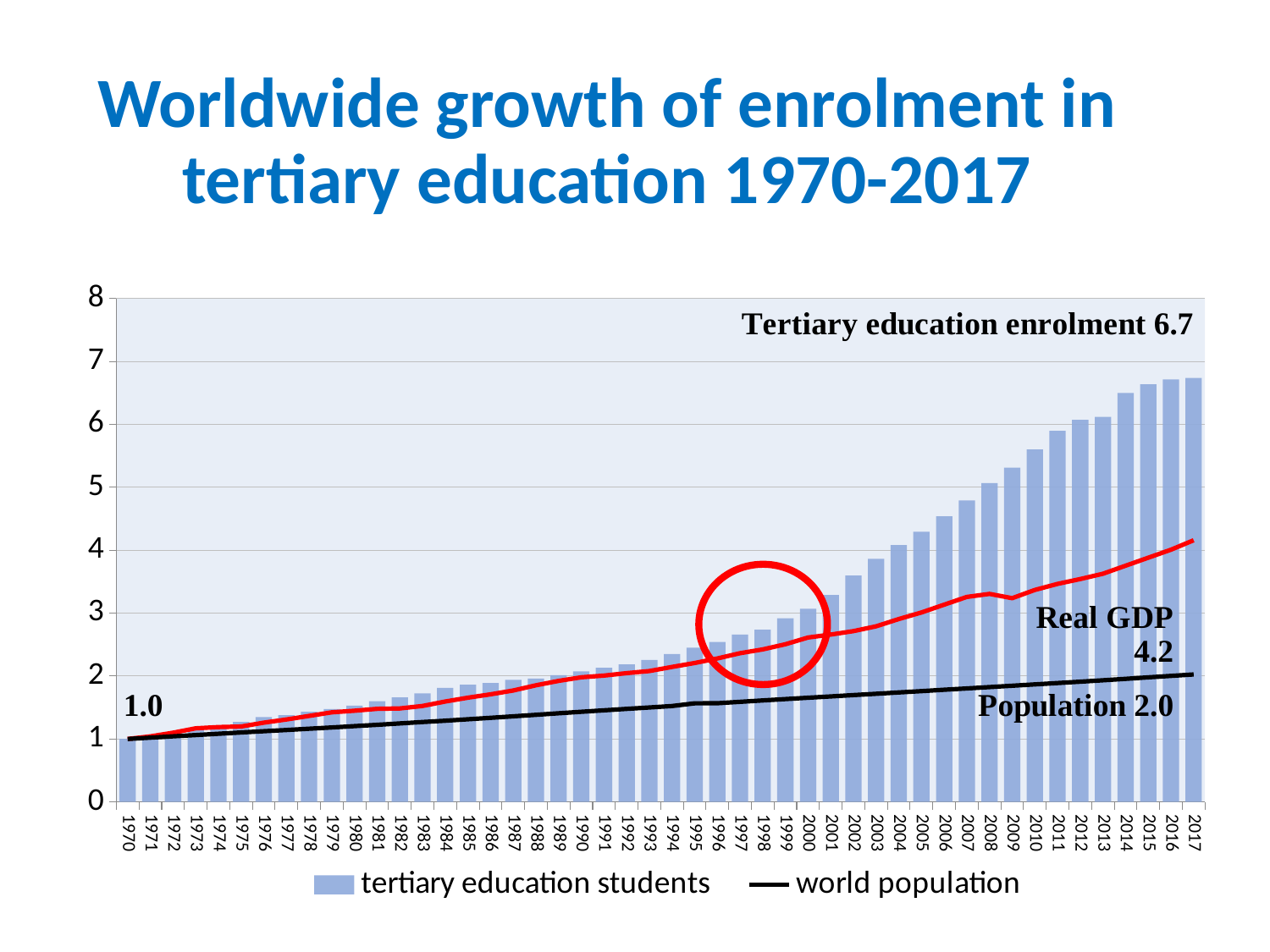
Do the tertiary education students bars rise or fall from 1970 to 2017? Rise Is the tertiary education students bar for 1980 greater or less than 2? less What is the Real GDP value labelled at the end of the red line? 4.2 What is the starting value labelled at 1970? 1.0 What is the tertiary education enrolment value shown for 2017? 6.7 Which is larger at the end of the period: tertiary education enrolment or Real GDP? Tertiary education enrolment What is the difference between the tertiary education enrolment value (6.7) and the Population value (2.0)? 4.7 How many series does the legend list? 2 Which year has the shortest tertiary education students bar? 1970 What is the Population value labelled at the end of the black line? 2.0 Is the tertiary education students bar for 2010 greater or less than 5? greater Which year has the tallest tertiary education students bar? 2017